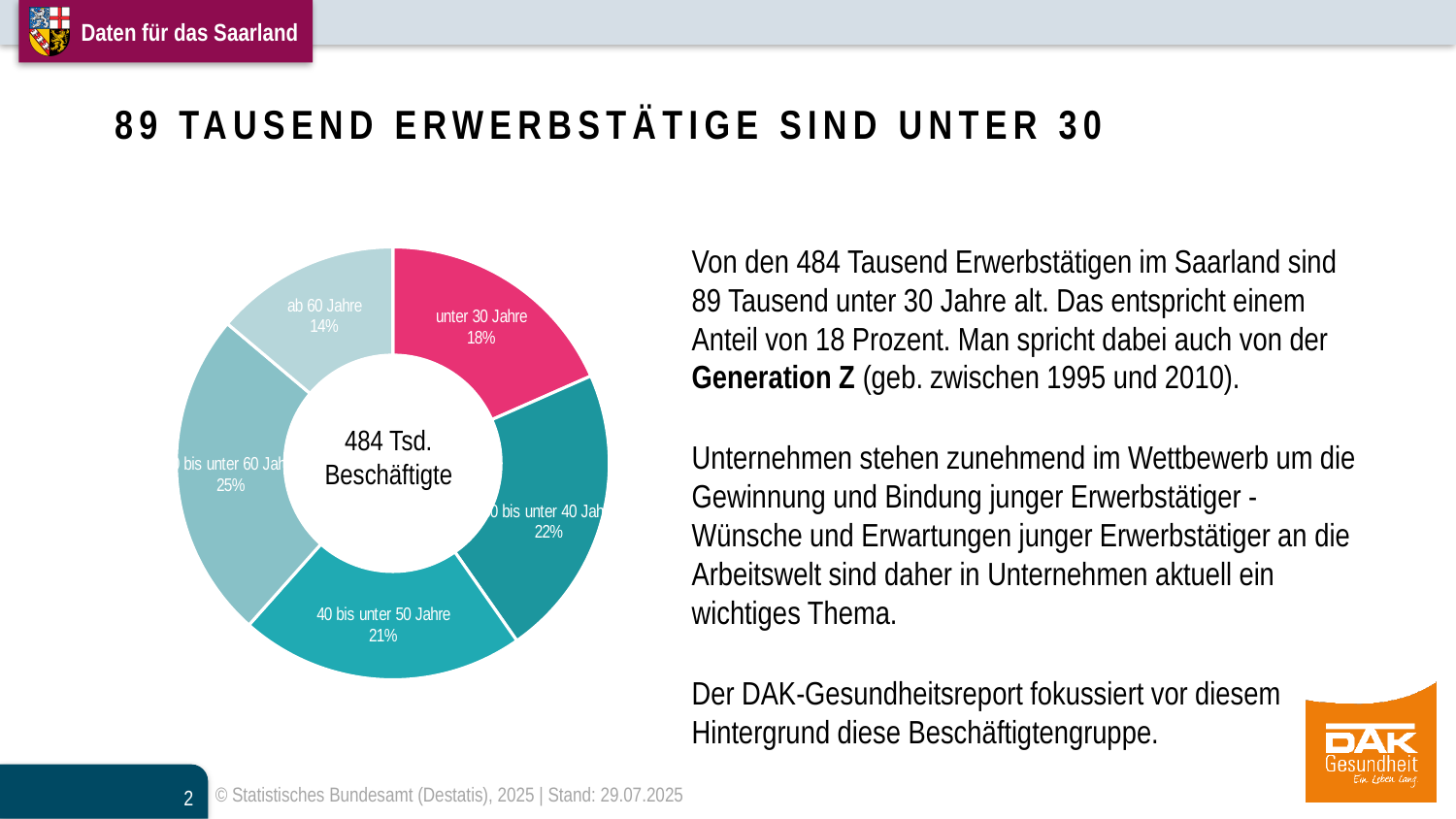
What text is shown in the centre of the donut chart? 484 Tsd. Beschäftigte What percentage does the '40 bis unter 50 Jahre' segment show? 21% What percentage does the '30 bis unter 40 Jahre' segment show? 22% Which age group has the largest share in the donut chart? 50 bis unter 60 Jahre What colour is the 'unter 30 Jahre' segment? Pink/magenta What percentage does the 'ab 60 Jahre' segment show? 14% How many age-group segments does the donut chart have? 5 What percentage does the 'unter 30 Jahre' segment of the donut chart show? 18% What type of chart is shown on the slide? Pie (donut) chart Which share is larger: 'unter 30 Jahre' or '40 bis unter 50 Jahre'? 40 bis unter 50 Jahre Which age group has the smallest share in the donut chart? ab 60 Jahre By how many percentage points is the 'unter 30 Jahre' share larger than the 'ab 60 Jahre' share? 4 percentage points